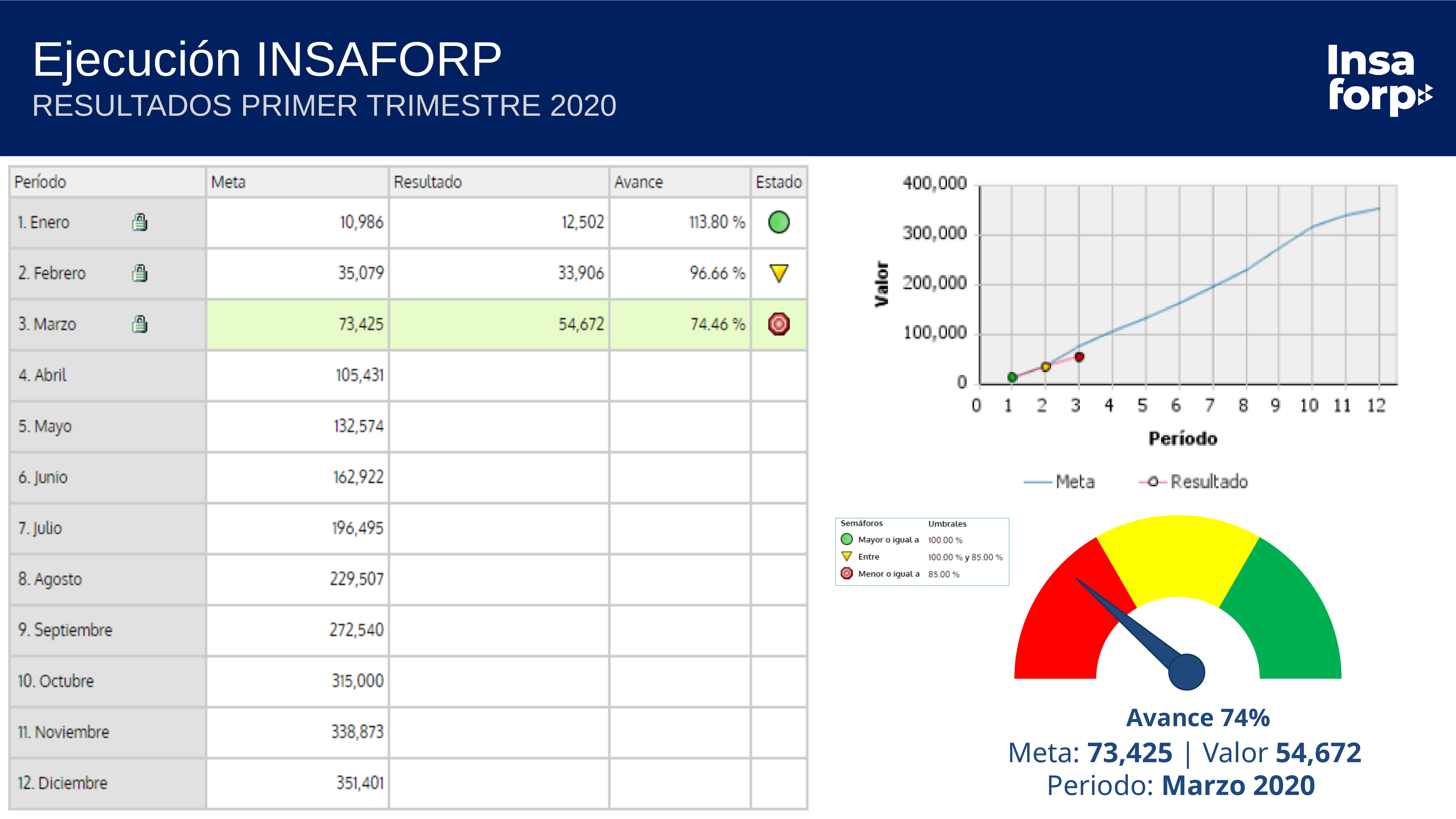
In the line chart at the top right, is the Meta value at Período 6 greater or less than 200,000? less In the line chart at the top right, at Período 3, which is higher: Meta or Resultado? Meta In the line chart at the top right, what are the two legend entries? Meta and Resultado In the gauge chart at the bottom right, what Avance percentage is shown? 74% In the line chart at the top right, is the Resultado value at Período 3 greater or less than 100,000? less In the line chart at the top right, does the Meta line rise or fall as Período increases from 1 to 12? rise In the gauge chart at the bottom right, what is the Meta value shown below the gauge? 73,425 What kind of chart is the chart at the top right of the slide, plotting Valor against Período? line chart In the gauge chart at the bottom right, which colour zone does the needle point into? red In the line chart at the top right, how many series does the legend list? 2 In the line chart at the top right, how many data points does the Resultado series have? 3 In the line chart at the top right, is the Meta value at Período 12 greater or less than 300,000? greater